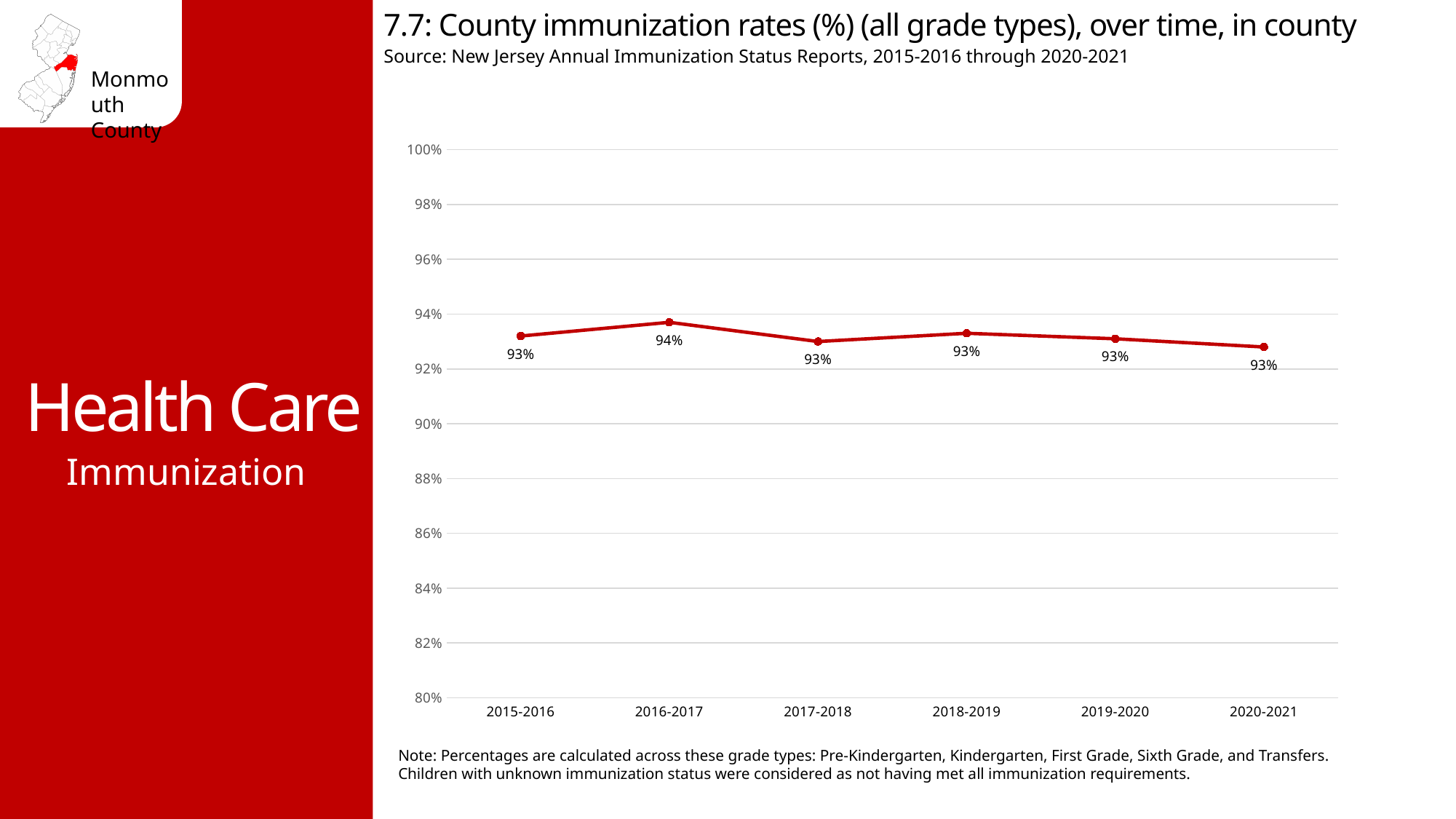
Did the immunization rate rise or fall from 2016-2017 to 2017-2018? Fall Which school year had the highest immunization rate? 2016-2017 Is the immunization rate for 2018-2019 greater or less than 90%? greater What type of chart is shown on the slide? Line chart What was the county immunization rate in 2015-2016? 93% What is the difference between the immunization rate in 2016-2017 and in 2015-2016? 1% How many school years are plotted on the chart? 6 Which year had a higher immunization rate, 2016-2017 or 2017-2018? 2016-2017 What is the lowest value shown on the vertical axis of the chart? 80% What was the county immunization rate in 2016-2017? 94% What was the county immunization rate in 2020-2021? 93% What is the source of the data shown in the chart? New Jersey Annual Immunization Status Reports, 2015-2016 through 2020-2021